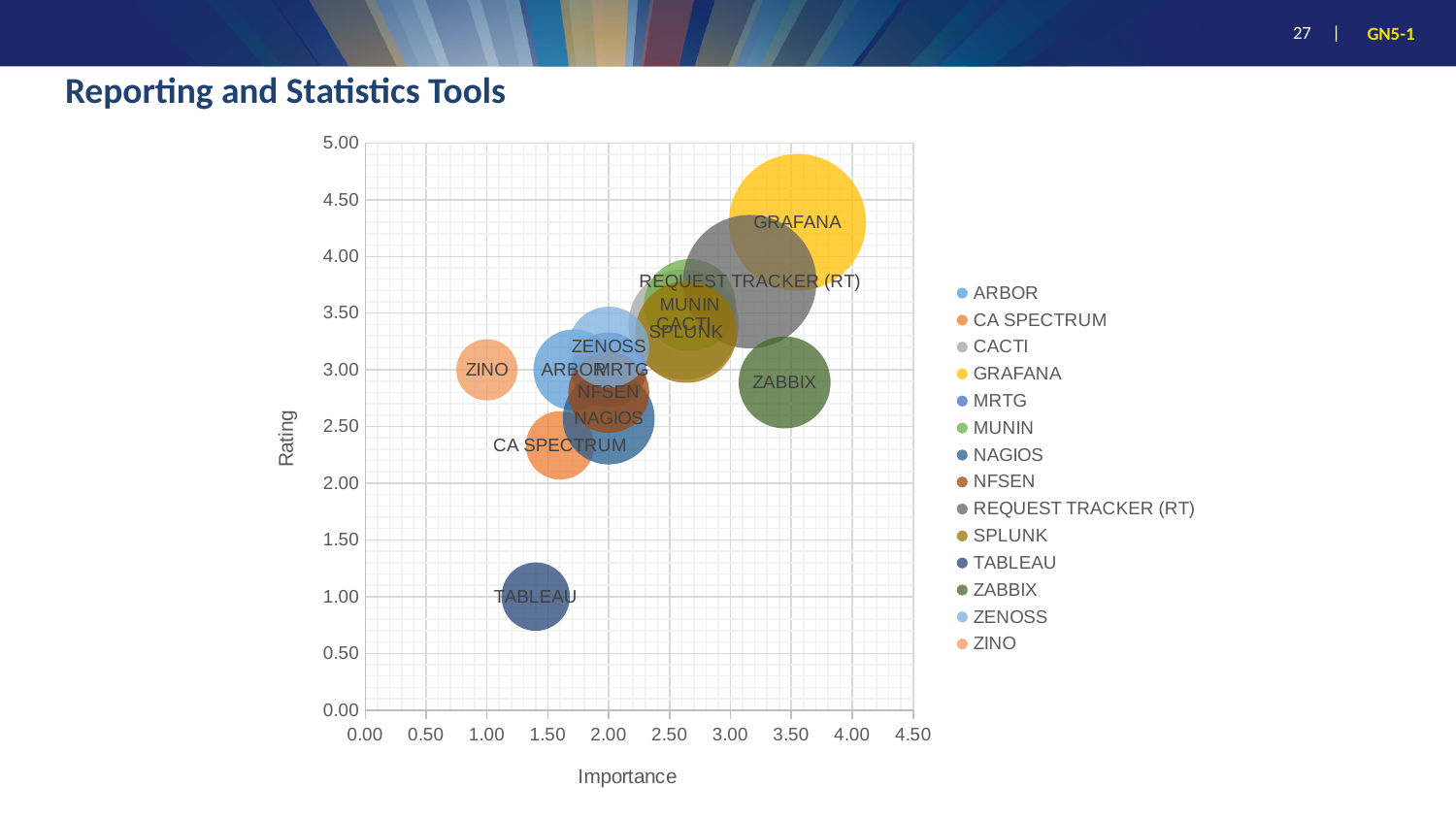
How many series does the legend list? 14 Is the rating for TABLEAU greater or less than 1.50? less Is the importance for ZABBIX greater or less than 3.00? greater Which has the higher importance, ZINO or ZABBIX? ZABBIX Is the importance for ZINO greater or less than 1.50? less What kind of chart is shown on the slide? Bubble chart Which tool has the highest rating? GRAFANA Which tool has the lowest importance? ZINO What is the label of the horizontal axis? Importance Which tool has the lowest rating? TABLEAU